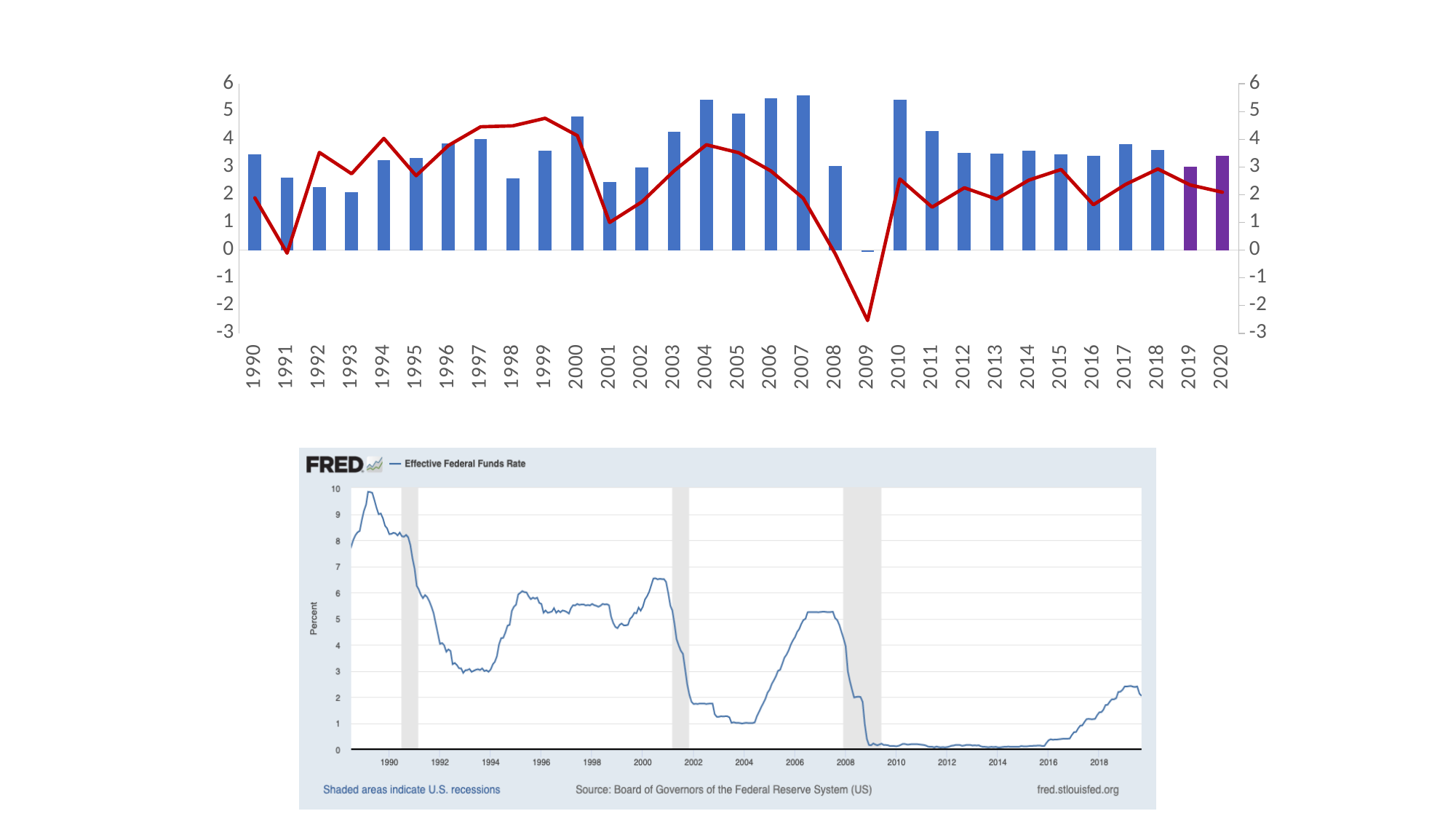
In the top chart, how many years are shown on the x axis? 31 In the top chart, what colour are the bars for 2019 and 2020? purple What kind of chart is the bottom chart (Effective Federal Funds Rate)? line chart In the top chart, which bar is taller, 2004 or 2001? 2004 In the top chart, which year has the lowest bar? 2009 In the top chart, does the red line rise or fall from 2005 to 2009? fall In the top chart, is the bar for 2007 greater or less than 5? greater In the top chart, is the red line value for 2009 greater or less than -2? less In the bottom chart, is the Effective Federal Funds Rate in 2012 greater or less than 1? less In the bottom chart, does the Effective Federal Funds Rate rise or fall from 2016 to 2019? rise In the top chart, which year has the lowest value on the red line? 2009